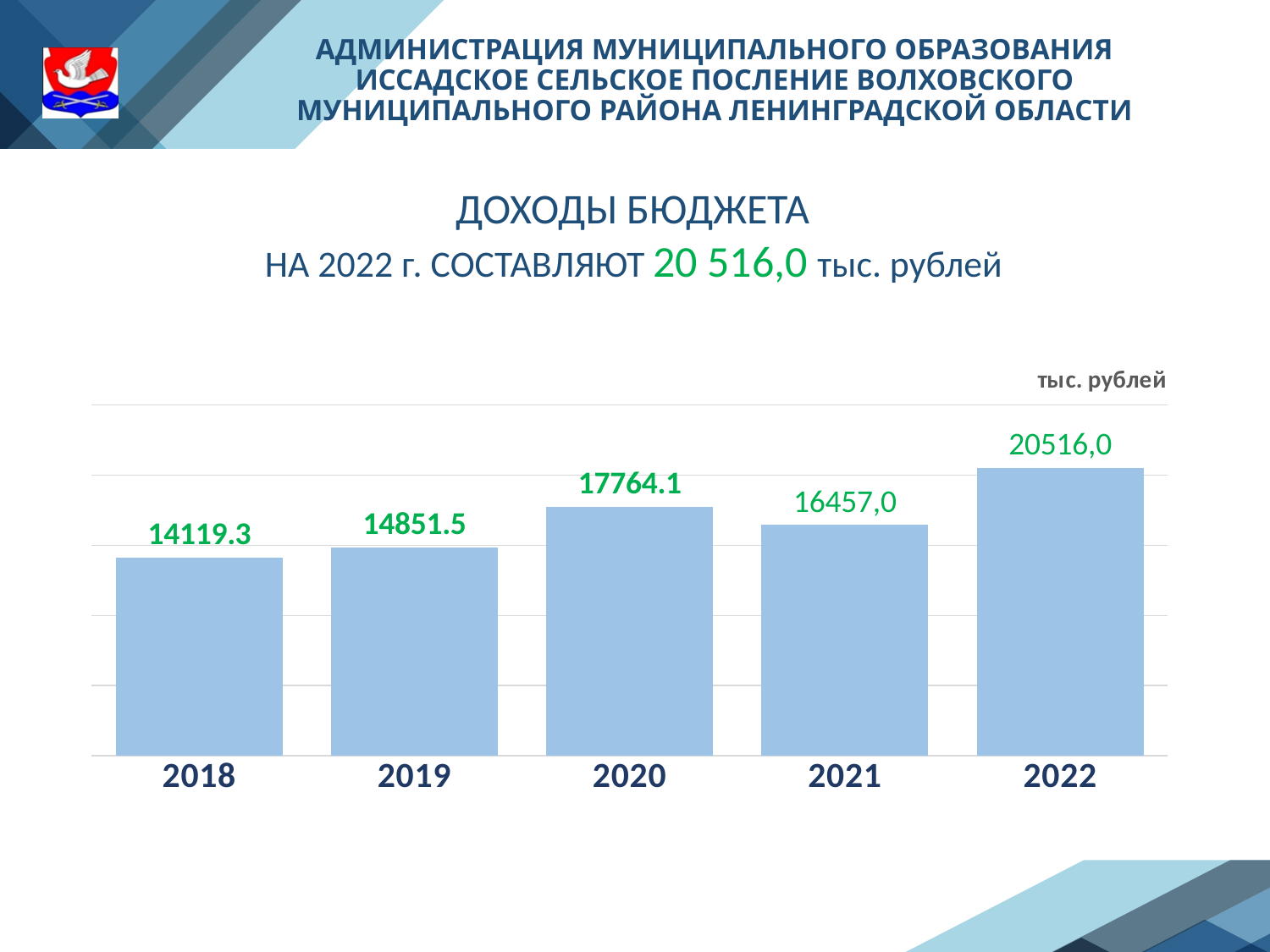
What is the budget revenue value shown for 2021? 16457,0 Did the budget revenue rise or fall from 2020 to 2021? fall Which year has the lowest budget revenue in the chart? 2018 What is the budget revenue value shown for 2020? 17764.1 What is the budget revenue value shown for 2022? 20516,0 Which year has the highest budget revenue in the chart? 2022 What is the difference between the 2020 and 2019 values? 2912.6 How many years (bars) are shown in the chart? 5 What type of chart is shown on the slide? bar chart By how much does the 2022 value exceed the 2021 value? 4059,0 Which is larger, the value for 2020 or the value for 2021? 2020 What is the budget revenue value shown for 2018? 14119.3